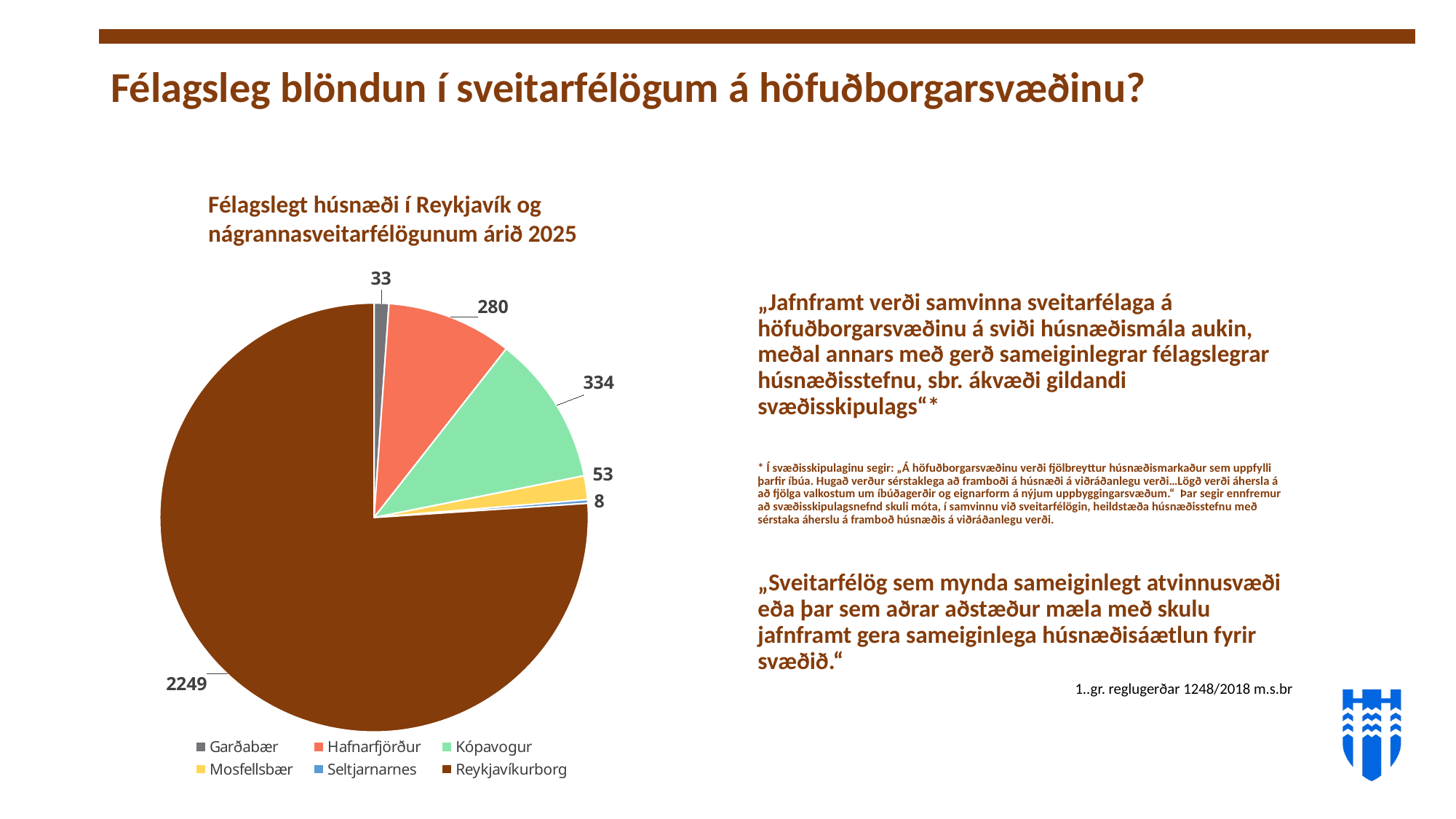
What is the difference between the values for Kópavogur and Hafnarfjörður? 54 What is the value for Kópavogur in the pie chart? 334 What is the value for Reykjavíkurborg in the pie chart? 2249 What is the title of the pie chart? Félagslegt húsnæði í Reykjavík og nágrannasveitarfélögunum árið 2025 What is the value for Hafnarfjörður in the pie chart? 280 What is the total of all values in the pie chart? 2957 Which municipality has the smallest slice in the pie chart? Seltjarnarnes Which municipality has the largest slice in the pie chart? Reykjavíkurborg What is the value for Seltjarnarnes in the pie chart? 8 How many municipalities are shown in the pie chart? 6 Which is larger, the value for Mosfellsbær or the value for Garðabær? Mosfellsbær What type of chart is shown on the slide? pie chart